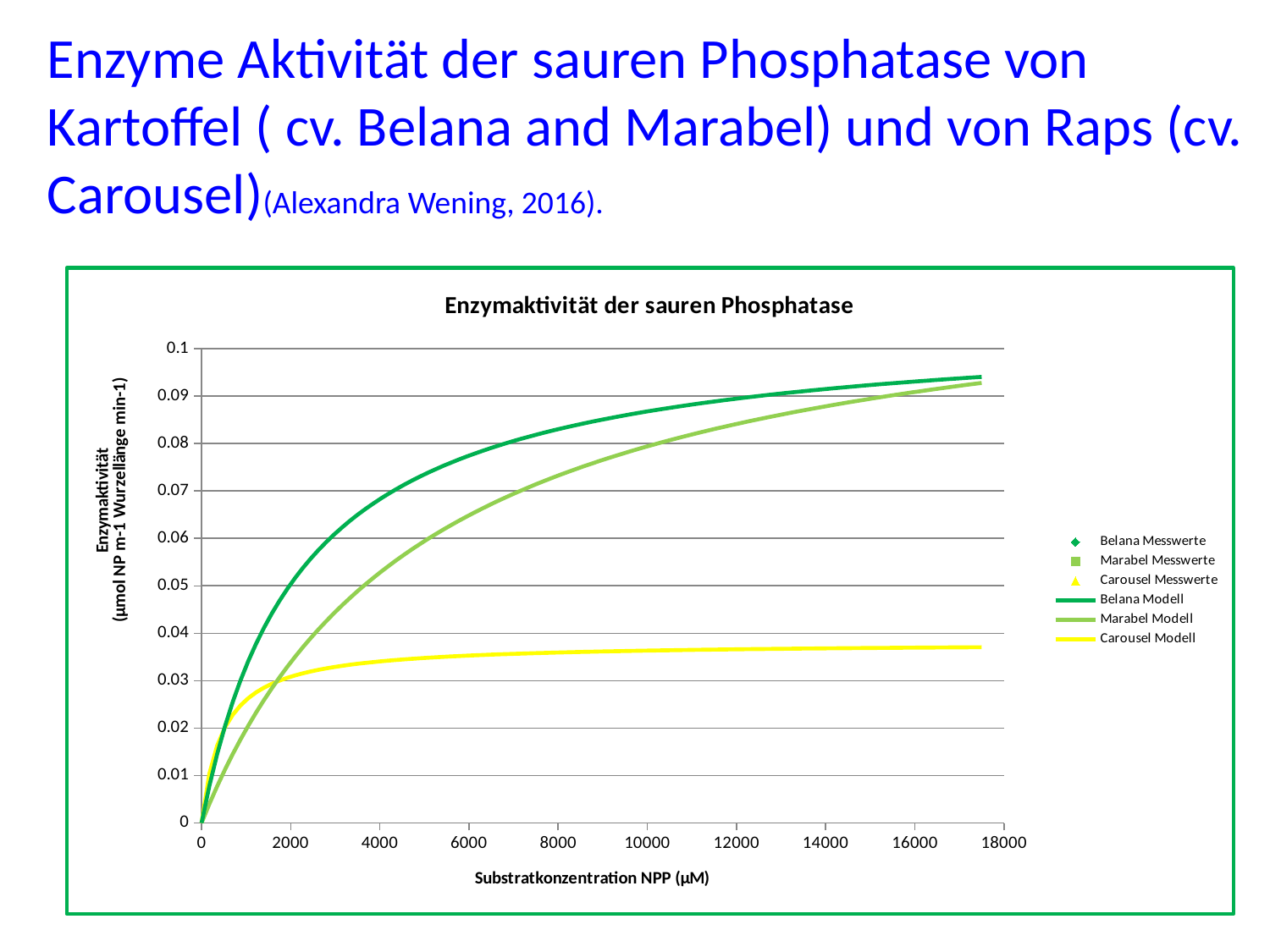
At a substrate concentration of 500 µM, which is larger: the Carousel Modell value or the Marabel Modell value? Carousel Modell What is the title of the chart? Enzymaktivität der sauren Phosphatase Which model curve is the lowest at a substrate concentration of 18000 µM? Carousel Modell At a substrate concentration of 10000 µM, which is larger: the Belana Modell value or the Marabel Modell value? Belana Modell What is the label of the x axis? Substratkonzentration NPP (µM) Is the Carousel Modell value at 10000 µM greater or less than 0.04? less Is the Marabel Modell value at 6000 µM greater or less than 0.06? greater Which model curve is the highest at a substrate concentration of 8000 µM? Belana Modell Does the Belana Modell curve rise or fall as substrate concentration increases along the x axis? rise How many series does the legend list? 6 Is the Belana Modell value at 10000 µM greater or less than 0.08? greater What kind of chart is shown on the slide? line chart